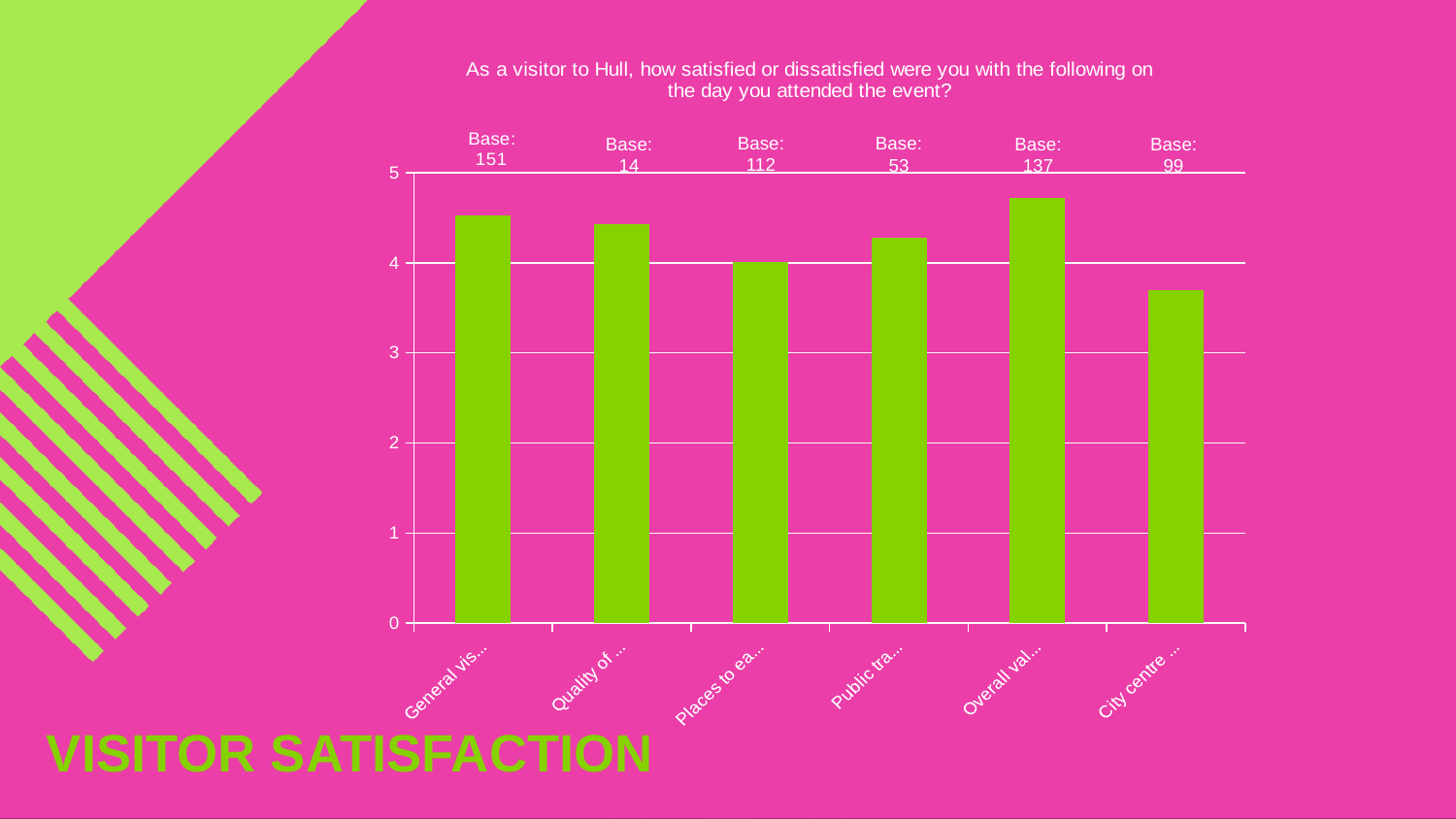
Which bar is taller, 'Overall val...' or 'Public tra...'? Overall val... Which category has the lowest bar in the chart? City centre ... (the sixth bar) What is the base (number of respondents) shown above the 'General vis...' bar? 151 What is the highest value shown on the chart's vertical axis? 5 Is the value for the 'General vis...' bar greater or less than 4? greater Is the value for the 'Overall val...' bar greater or less than 4? greater What kind of chart is shown on the slide? bar chart Which category has the highest bar in the chart? Overall val... (the fifth bar) What is the base shown above the 'Quality of ...' bar? 14 Which bar is taller, 'General vis...' or 'City centre ...'? General vis... Is the value for the 'City centre ...' bar greater or less than 4? less How many bars (categories) are plotted in the chart? 6